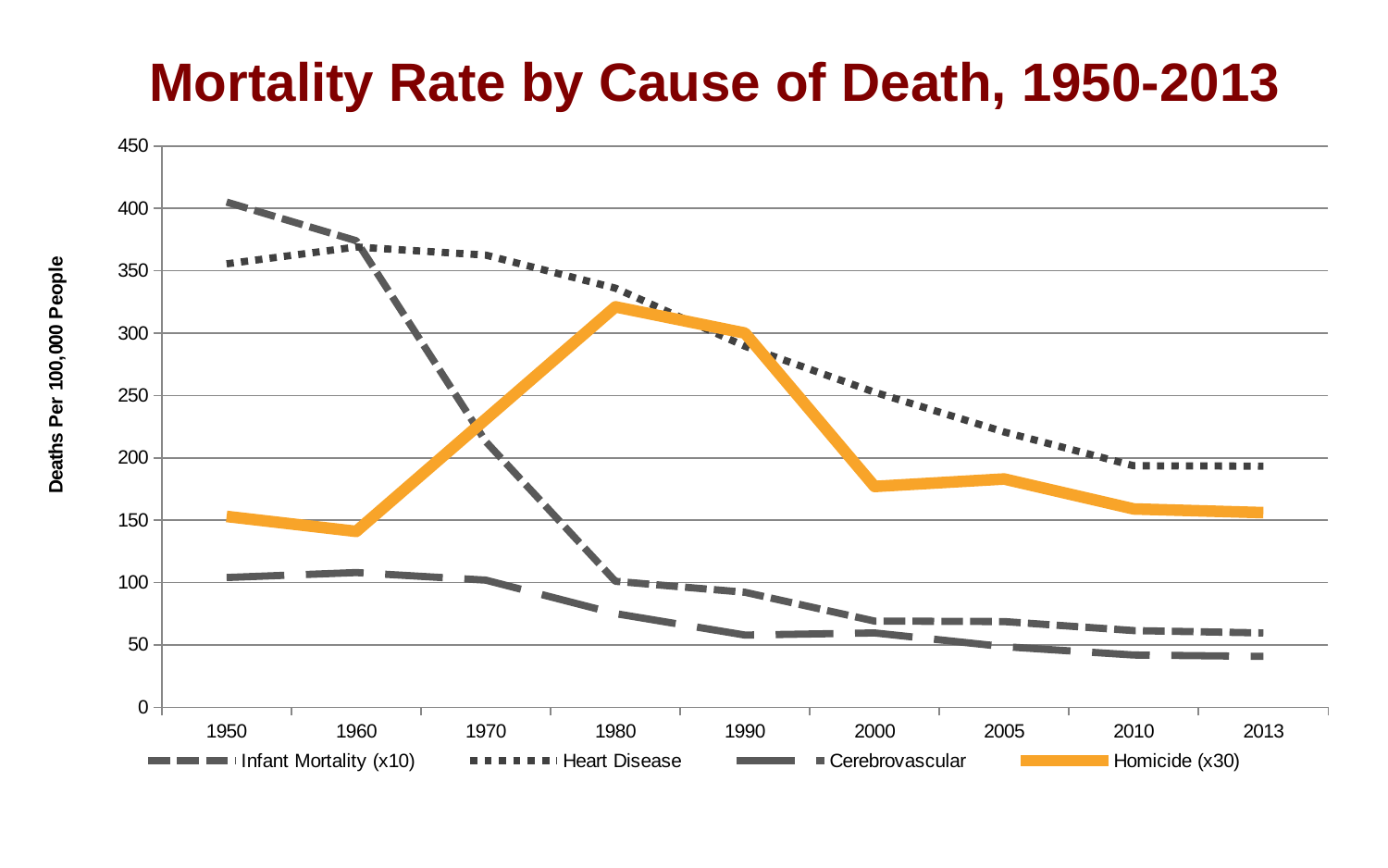
Which series has the highest value in 1950? Infant Mortality (x10) Is the value for Homicide (x30) in 1980 greater or less than 300? greater In which year does the Homicide (x30) series reach its highest value? 1980 How many series does the legend list? 4 Is the value for Heart Disease in 2013 greater or less than 250? less What kind of chart is shown on the slide? Line chart Which series has the lowest value in 2013? Cerebrovascular Is the value for Cerebrovascular in 2013 greater or less than 50? less How many years are marked along the x axis? 9 In 2000, which is larger: Heart Disease or Homicide (x30)? Heart Disease Does the Heart Disease series rise or fall from 1960 to 2013? Fall